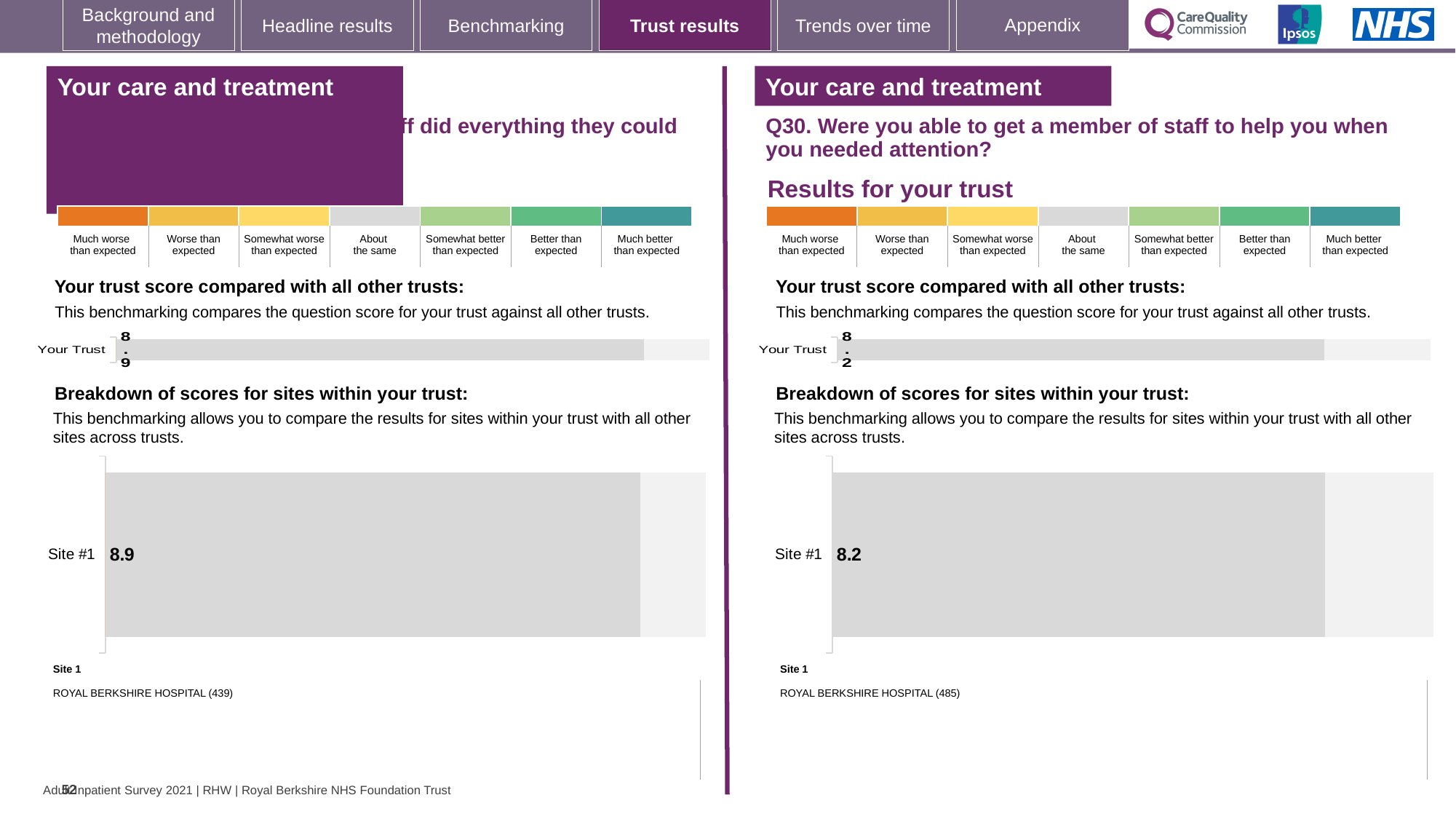
On the right-hand panel (Q30), what is the score shown for Your Trust? 8.2 Which panel shows the higher Your Trust score, the left-hand panel or the right-hand panel (Q30)? the left-hand panel On the left-hand panel, what is the score shown for Site #1? 8.9 On the right-hand panel, is the Your Trust score greater or less than the Site #1 score on the left-hand panel? less What is the difference between the Site #1 score on the left-hand panel and the Site #1 score on the right-hand panel (Q30)? 0.7 On the right-hand panel (Q30), which site is listed as Site 1? ROYAL BERKSHIRE HOSPITAL (485) On the right-hand panel (Q30), what is the score shown for Site #1? 8.2 On the left-hand panel, which site is listed as Site 1? ROYAL BERKSHIRE HOSPITAL (439) What kind of chart is used to show the Site #1 score on the left-hand panel? bar chart On the left-hand panel, what is the score shown for Your Trust? 8.9 How many sites are shown in the breakdown of scores on the right-hand panel (Q30)? 1